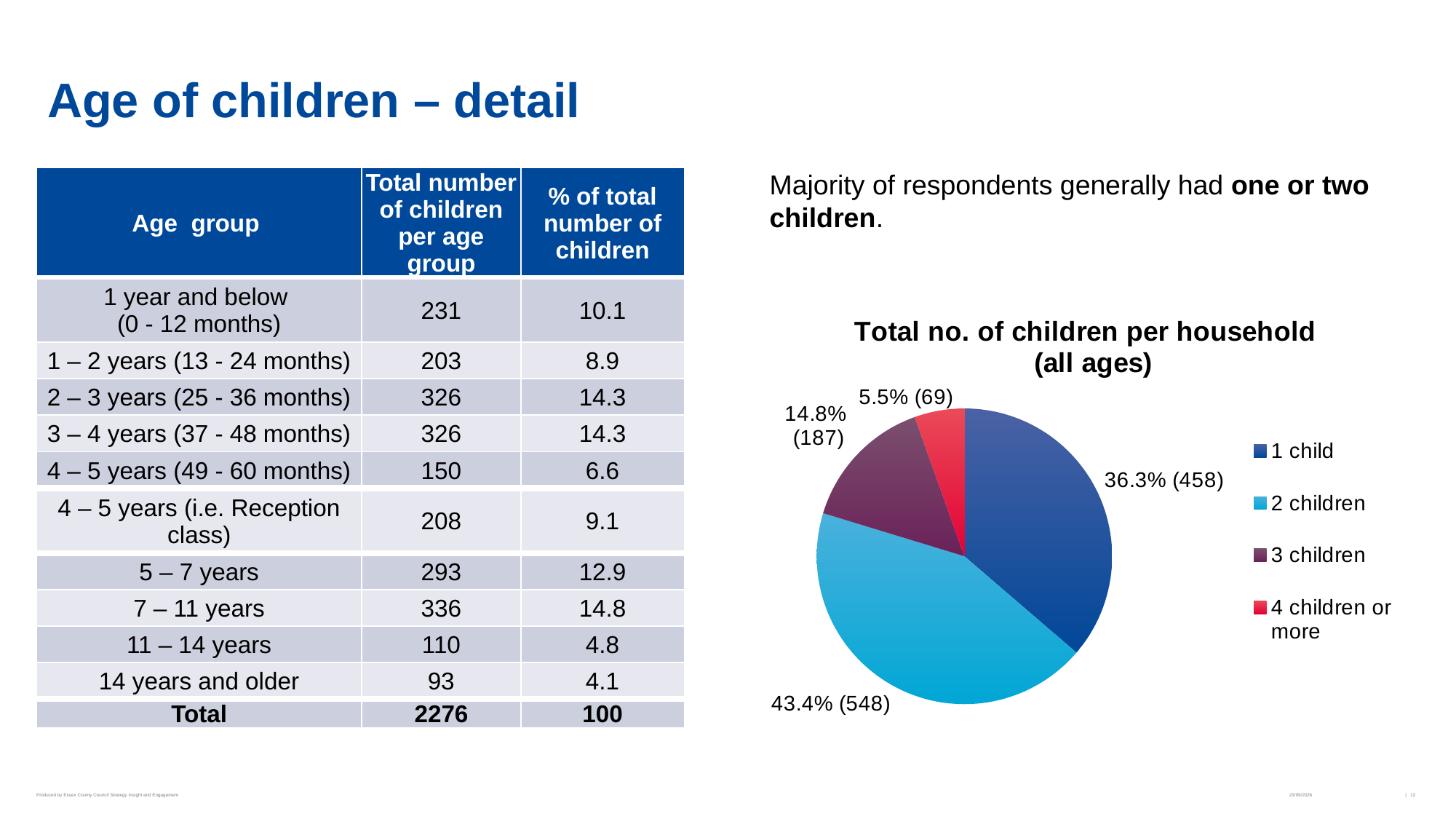
How many entries does the pie chart legend list? 4 How many slices does the pie chart have? 4 What kind of chart is shown on the slide? pie chart How many households have 4 children or more according to the pie chart? 69 In the pie chart, how many more households have 2 children than 1 child? 90 How many households have 3 children according to the pie chart? 187 What percentage of households have 1 child according to the pie chart? 36.3% What percentage of households have 2 children according to the pie chart? 43.4% Which category has the largest slice in the pie chart? 2 children Which category has the smallest slice in the pie chart? 4 children or more What is the title of the pie chart? Total no. of children per household (all ages) In the pie chart, which is larger: the share for 3 children or the share for 4 children or more? 3 children